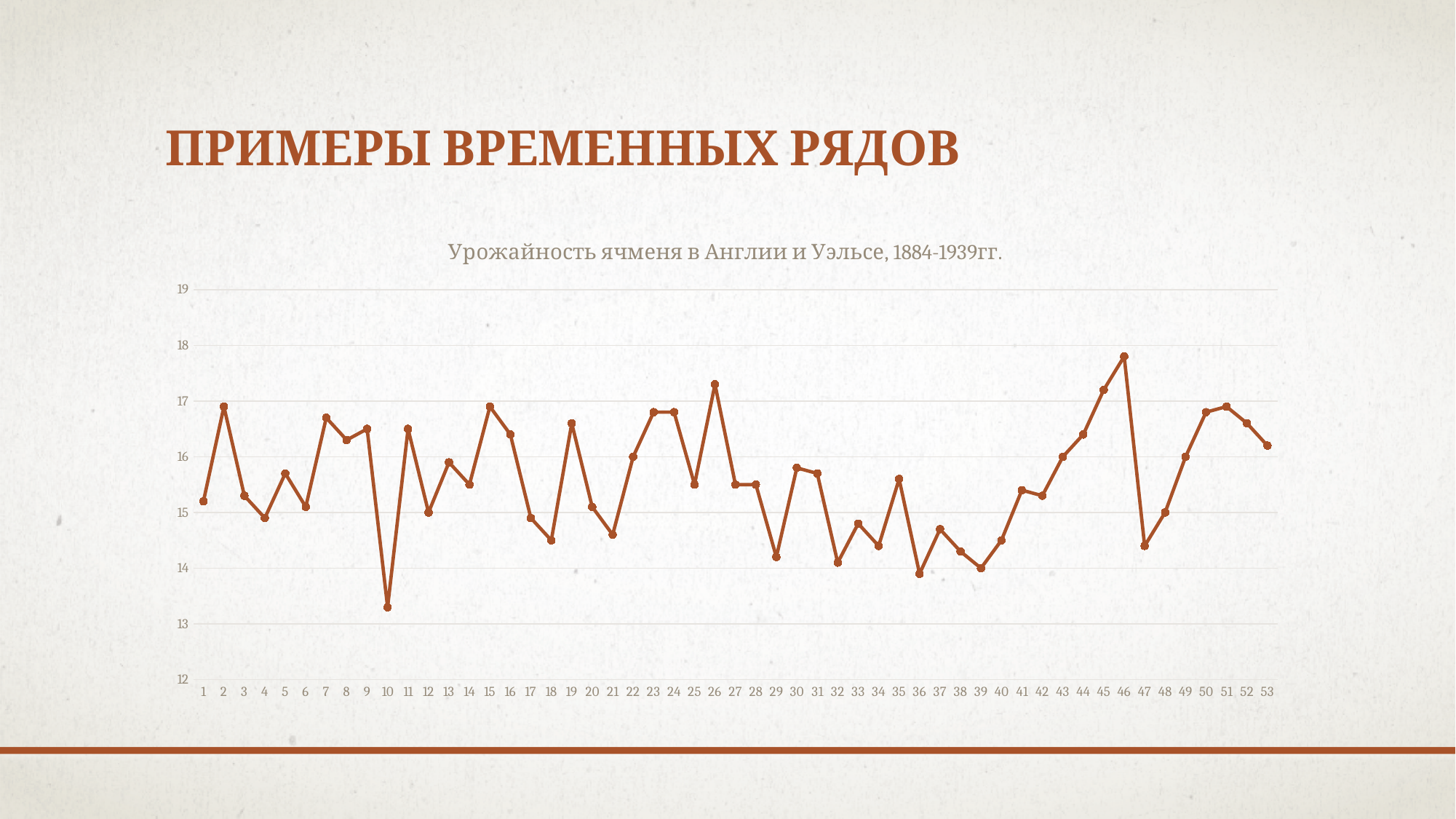
What is the title of the chart? Урожайность ячменя в Англии и Уэльсе, 1884-1939гг. Which has the larger value, point 39 or point 41? point 41 What kind of chart is shown on the slide? line chart Is the value at point 10 greater or less than 14? less At which x-axis point does the line reach its highest value? 46 Is the value at point 2 greater or less than 16? greater Is the value at point 46 greater or less than 17? greater Which has the larger value, point 2 or point 4? point 2 At which x-axis point does the line reach its lowest value? 10 How many points are plotted along the x axis of the chart? 53